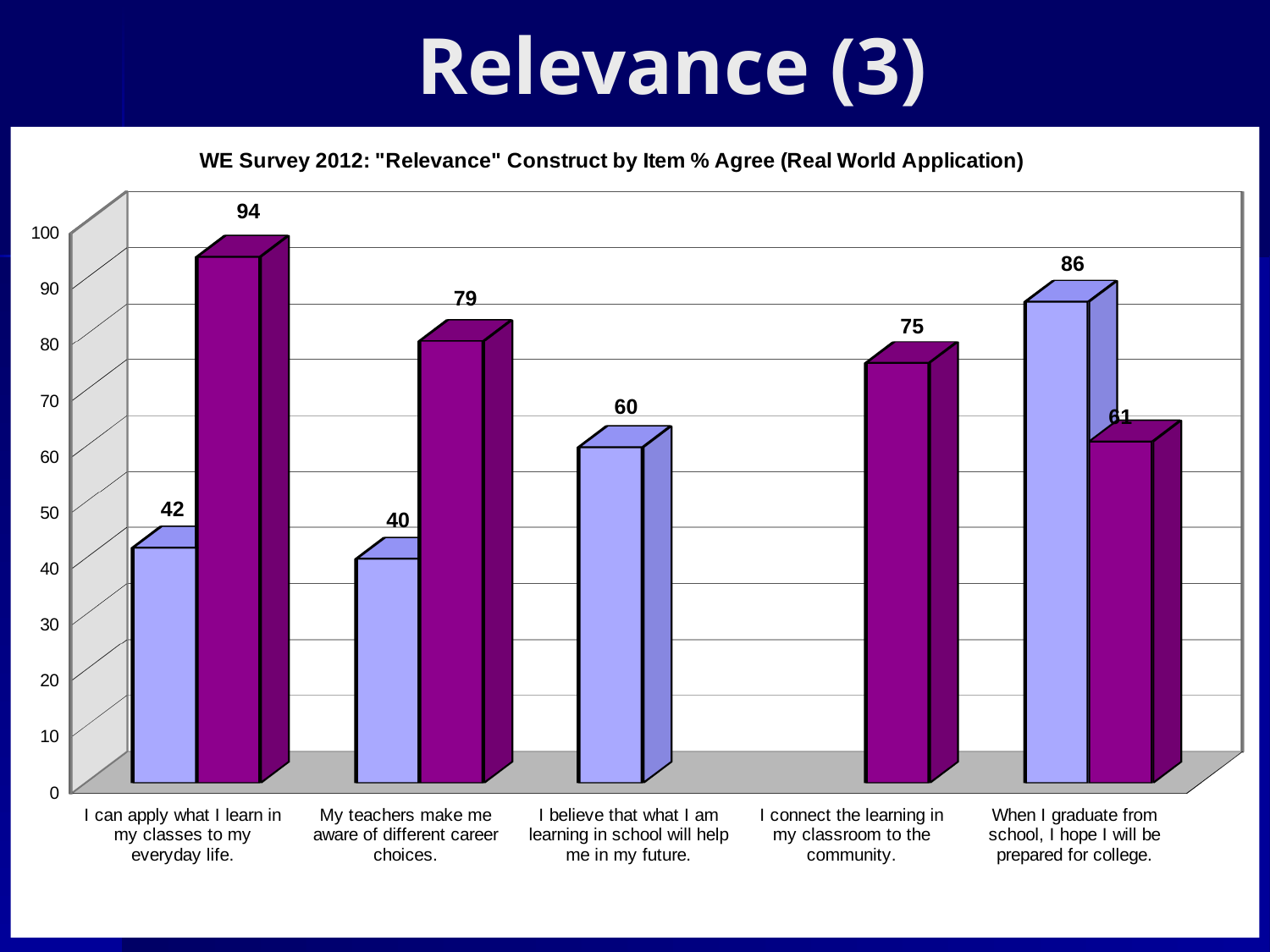
What is the difference between the purple and light blue bars for "I can apply what I learn in my classes to my everyday life."? 52 What is the value of the light blue bar for "When I graduate from school, I hope I will be prepared for college."? 86 What type of chart is shown on the slide? Bar chart What is the value shown for "I believe that what I am learning in school will help me in my future."? 60 What is the title of the chart? WE Survey 2012: "Relevance" Construct by Item % Agree (Real World Application) For "When I graduate from school, I hope I will be prepared for college.", which bar is larger, the light blue or the purple? Light blue Which bar has the lowest value on the chart? The light blue bar for "My teachers make me aware of different career choices." (40) What is the value of the purple bar for "I can apply what I learn in my classes to my everyday life."? 94 What is the value shown for "I connect the learning in my classroom to the community."? 75 How many categories are shown on the x axis? 5 Which bar has the highest value on the chart? The purple bar for "I can apply what I learn in my classes to my everyday life." (94) What is the value of the light blue bar for "My teachers make me aware of different career choices."? 40